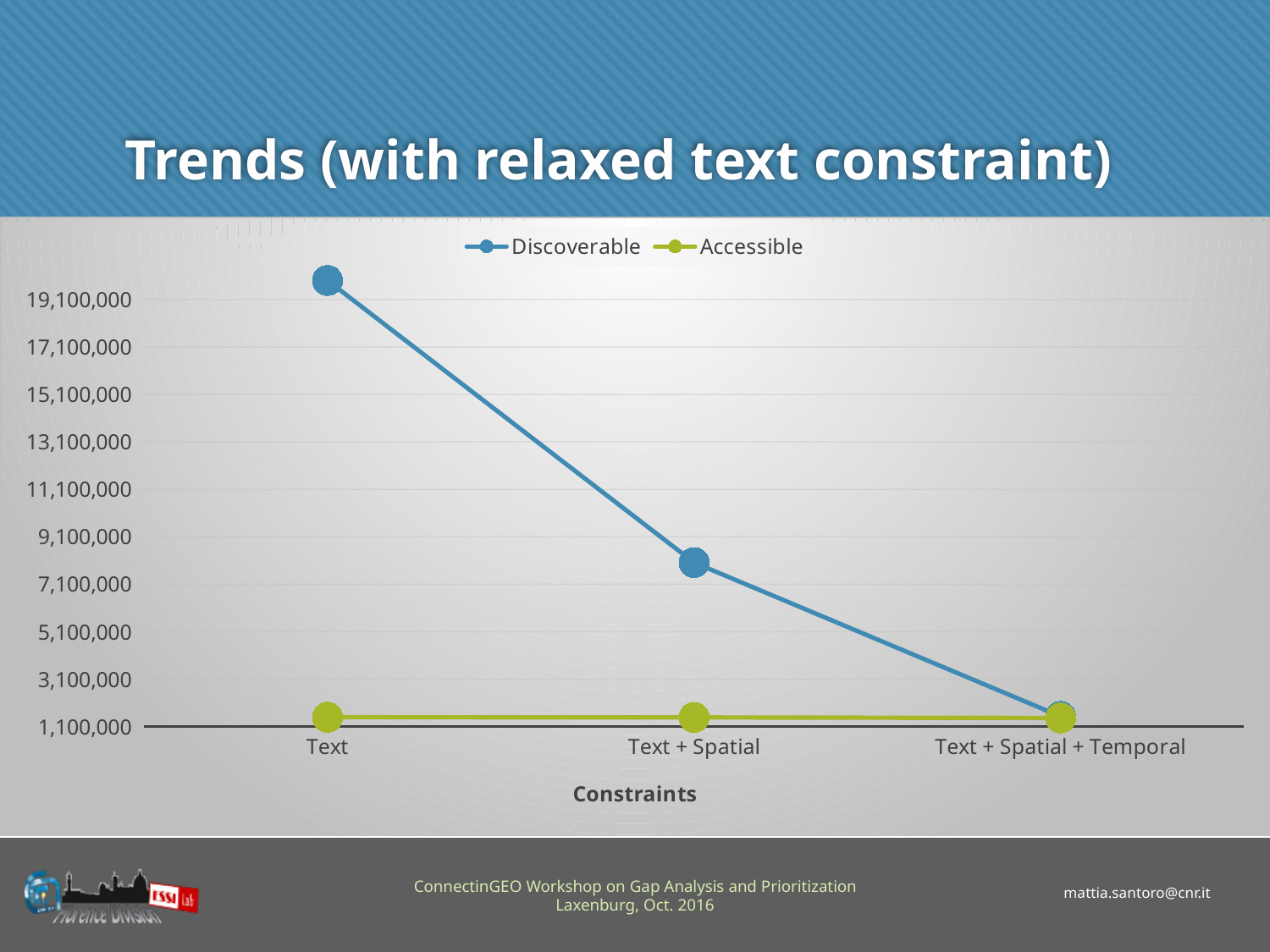
What is the title of the slide? Trends (with relaxed text constraint) Is the Discoverable value for Text greater or less than 17,100,000? greater What kind of chart is shown on the slide? line chart What is the title of the chart's x axis? Constraints Which series has the larger value at Text: Discoverable or Accessible? Discoverable For which constraint is the Discoverable value highest? Text Is the Discoverable value for Text + Spatial greater or less than 9,100,000? less How many categories are shown on the x axis? 3 Does the Discoverable series rise or fall from Text to Text + Spatial + Temporal? fall How many series does the legend list? 2 Is the Accessible value for Text + Spatial greater or less than 3,100,000? less For which constraint is the Discoverable value lowest? Text + Spatial + Temporal